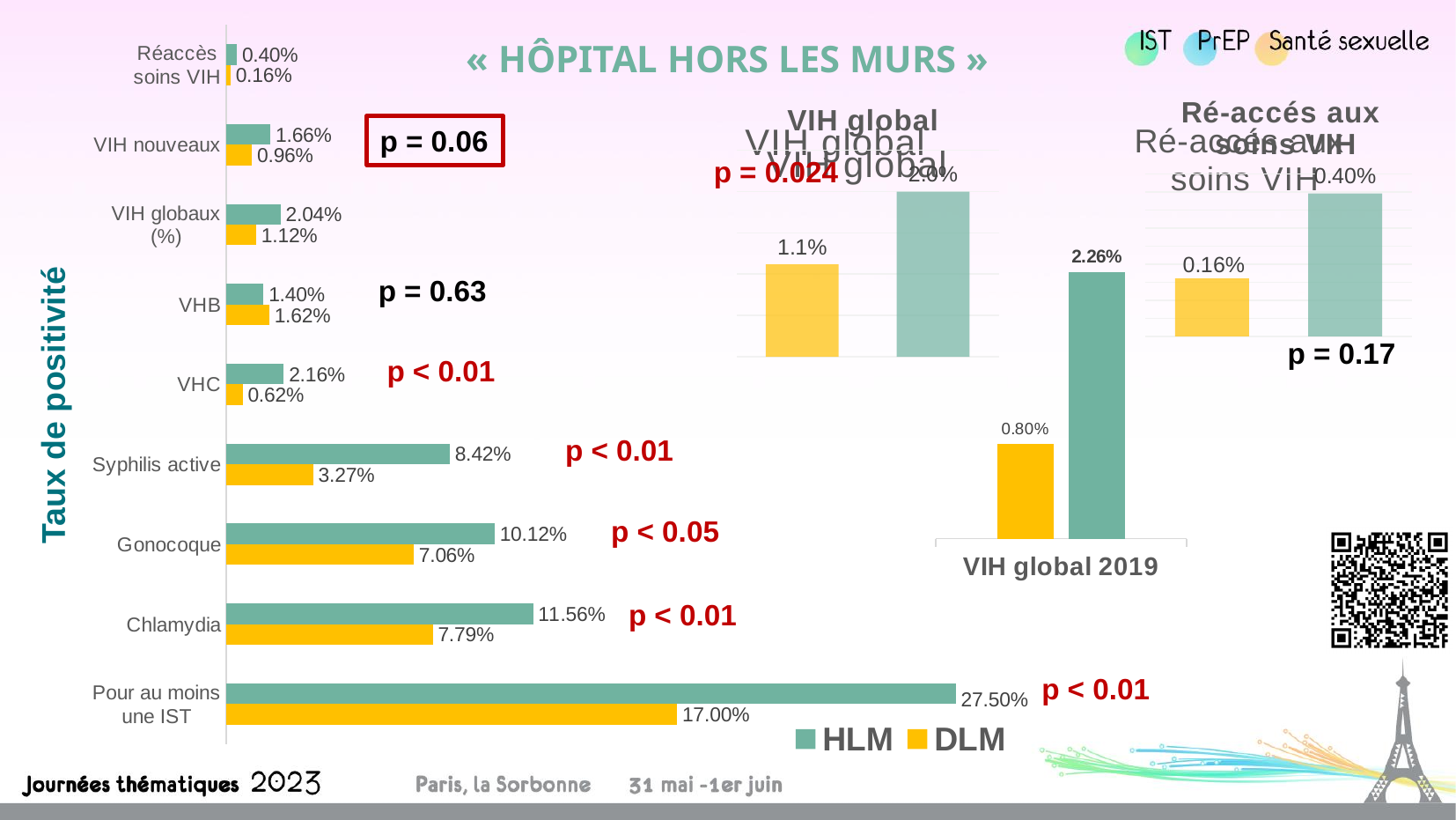
In the small chart titled VIH global 2019, what is the value of the green (HLM) bar? 2.26% In the main bar chart (Taux de positivité), what is the DLM value for Gonocoque? 7.06% How many series does the legend of the main bar chart (Taux de positivité) list? 2 What kind of chart is the main chart labelled Taux de positivité? Bar chart In the main bar chart (Taux de positivité), what is the difference between the HLM and DLM values for Pour au moins une IST? 10.50 percentage points In the main bar chart (Taux de positivité), which series has the larger value for VHB, HLM or DLM? DLM In the main bar chart (Taux de positivité), what is the DLM value for VHC? 0.62% In the main bar chart (Taux de positivité), what is the HLM value for Syphilis active? 8.42% In the main bar chart (Taux de positivité), which category has the lowest DLM value? Réaccès soins VIH In the main bar chart (Taux de positivité), which category has the highest HLM value? Pour au moins une IST In the main bar chart (Taux de positivité), what is the difference between the HLM and DLM values for Chlamydia? 3.77 percentage points How many categories are shown in the main bar chart (Taux de positivité)? 9